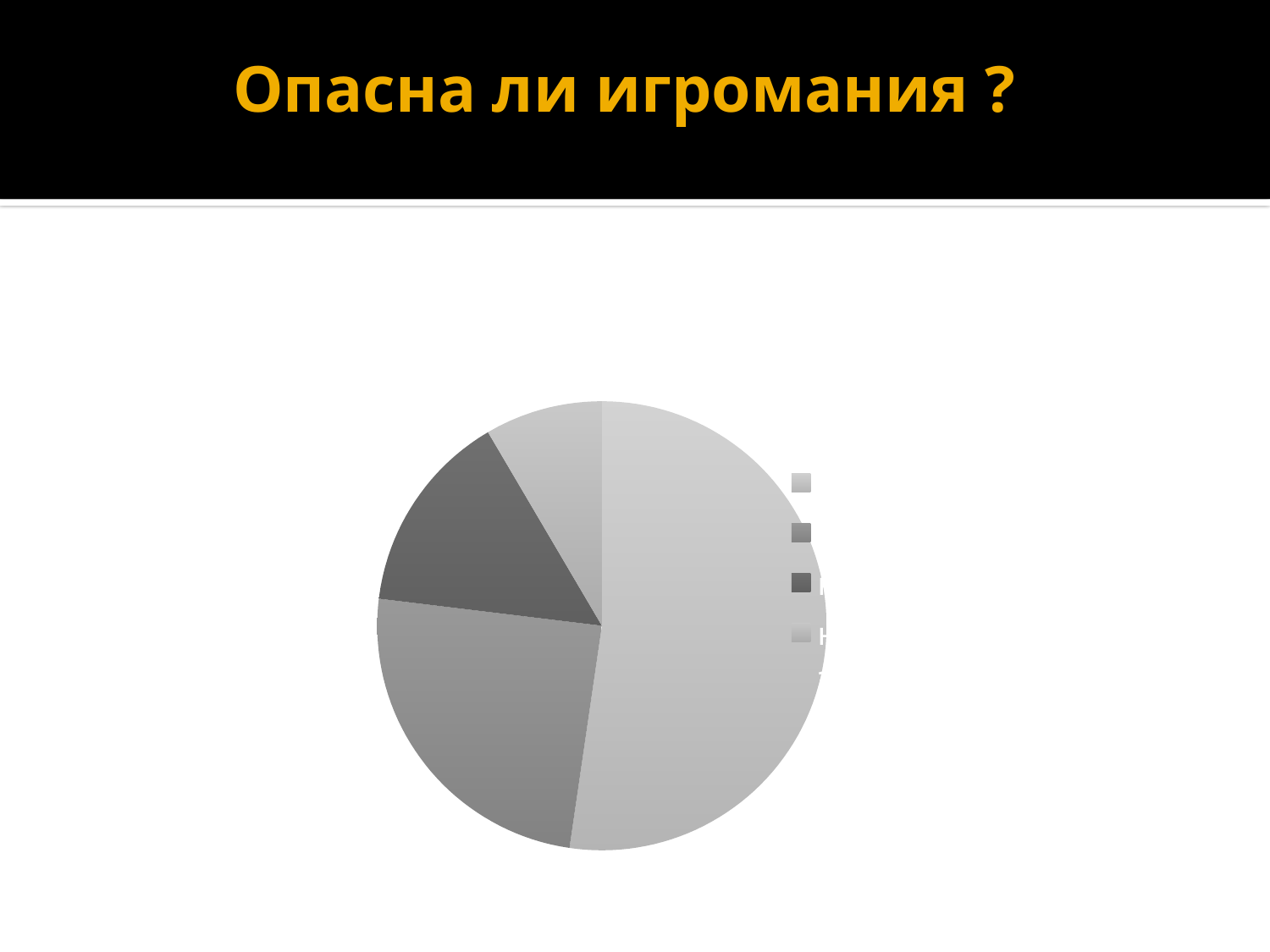
Does the largest slice of the pie chart take up more or less than a quarter of the pie? more How many entries does the legend of the pie chart list? 4 Where is the legend positioned relative to the pie chart? to the right Which slice of the pie chart is the smallest? the small light grey slice at the top Which slice is larger in the pie chart: the medium grey slice at the bottom left or the dark grey slice at the upper left? the medium grey slice at the bottom left Which slice of the pie chart is the largest: the lightest grey slice on the right, the medium grey slice at the bottom left, the dark grey slice at the upper left, or the small light grey slice at the top? the lightest grey slice on the right What kind of chart is shown on the slide? pie chart How many slices does the pie chart have? 4 What is the title of the slide containing the pie chart? Опасна ли игромания ?